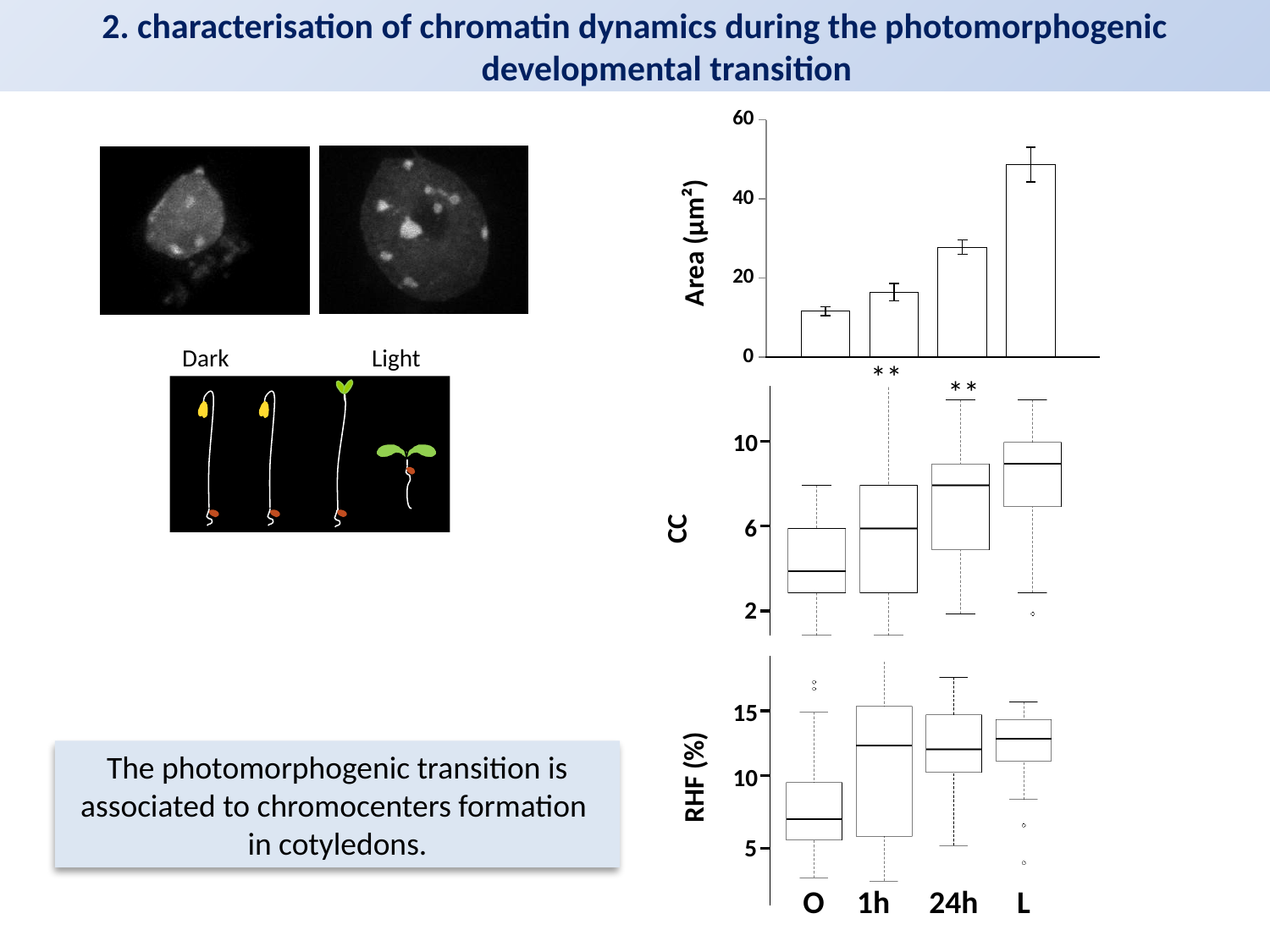
In the Area (µm²) bar chart, is the value for L greater or less than 40? greater In the Area (µm²) bar chart, do the bar values rise or fall from O to L along the x axis? rise In the Area (µm²) bar chart, is the value for 24h greater or less than 20? greater In the middle chart labelled CC, which category has the highest median line? L In the Area (µm²) bar chart, how many categories are shown on the x axis? 4 What kind of chart is the top-right chart with the y axis labelled Area (µm²)? bar chart In the Area (µm²) bar chart, which bar is taller, 1h or 24h? 24h In the Area (µm²) bar chart, which category has the highest bar? L In the Area (µm²) bar chart, which category has the lowest bar? O What is the y-axis label of the bottom-right chart? RHF (%) What is the y-axis label of the top-right bar chart? Area (µm²) In the Area (µm²) bar chart, is the value for O greater or less than 20? less